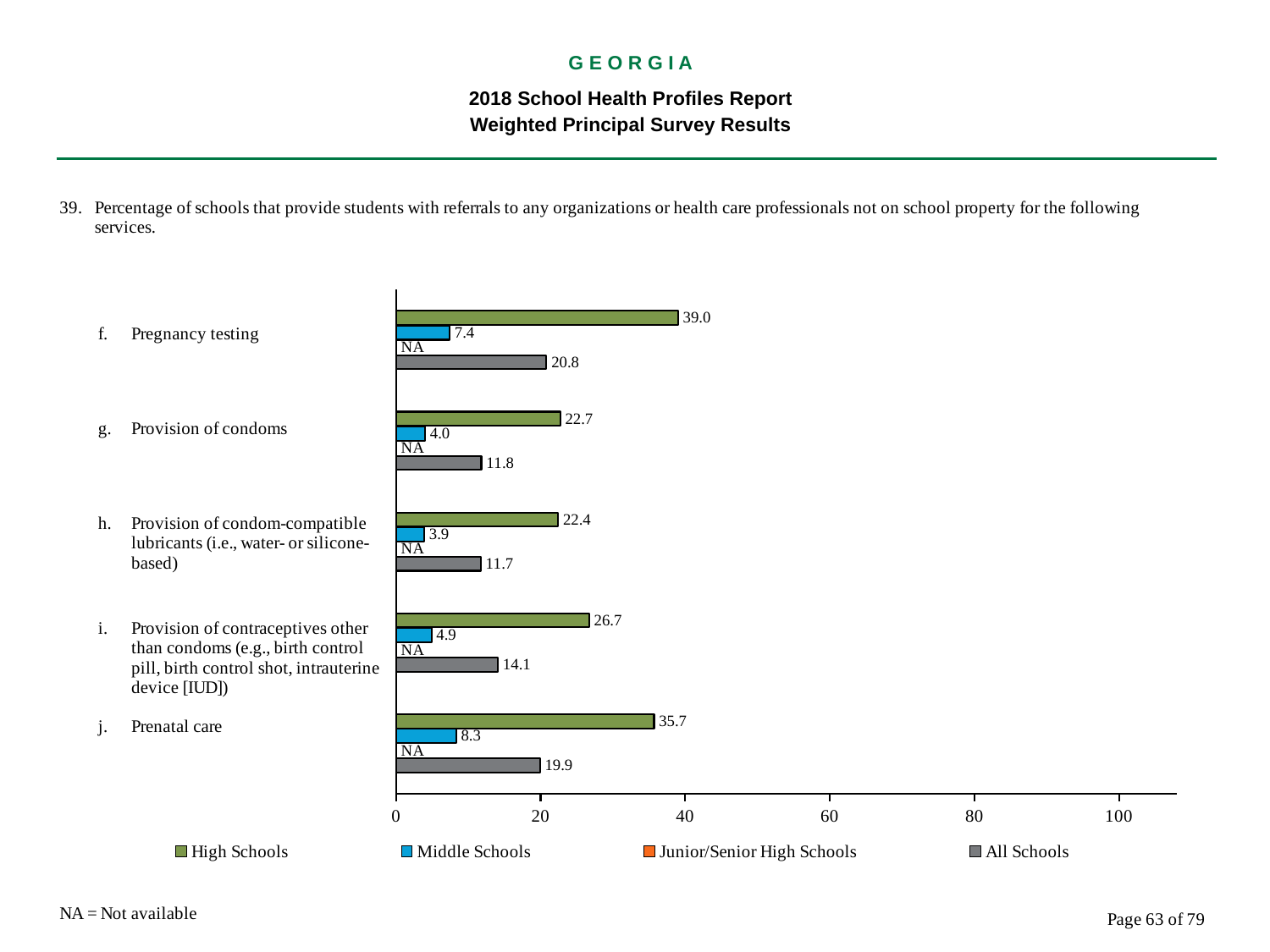
How many services (categories) are shown in the chart? 5 Which is larger: the Middle Schools value for Pregnancy testing or for Prenatal care? Prenatal care What is the Middle Schools value for Provision of condom-compatible lubricants? 3.9 What is the High Schools value for Pregnancy testing? 39.0 What is the All Schools value for Provision of condoms? 11.8 What kind of chart is shown on the slide? Bar chart What is the Middle Schools value for Prenatal care? 8.3 Which service has the lowest All Schools value? Provision of condom-compatible lubricants What value is shown for Junior/Senior High Schools for Provision of contraceptives other than condoms? NA Which service has the highest High Schools value? Pregnancy testing What is the difference between the High Schools and All Schools values for Prenatal care? 15.8 How many series does the legend list? 4